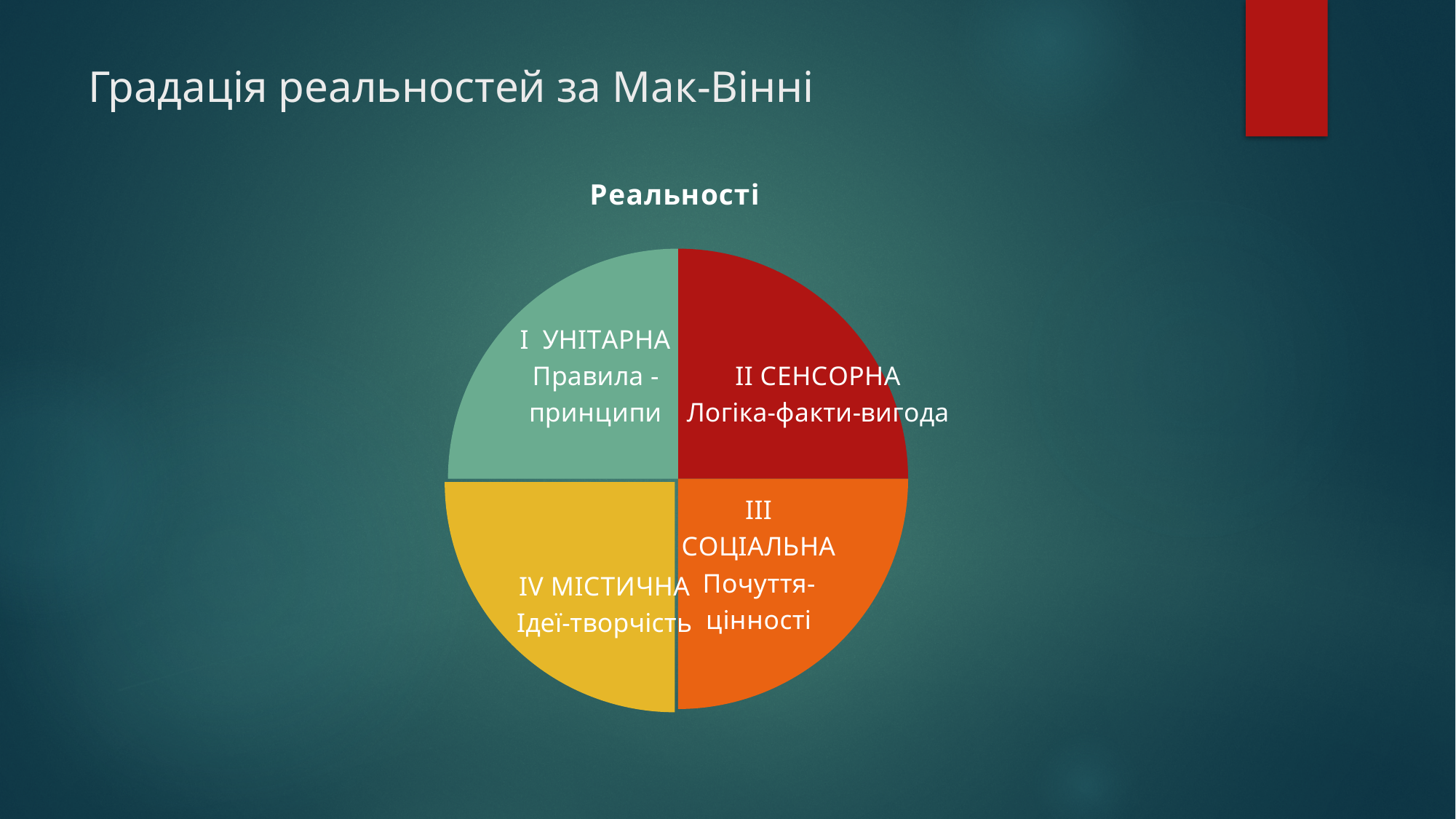
How many slices does the pie chart have? 4 What is the title of the pie chart? Реальності What description is written on the "III СОЦІАЛЬНА" slice of the pie chart? Почуття-цінності Which slice of the pie chart carries the description "Логіка-факти-вигода"? II СЕНСОРНА What description is written on the "IV МІСТИЧНА" slice of the pie chart? Ідеї-творчість What kind of chart is shown on the slide? pie chart Which slice of the pie chart is coloured dark red? II СЕНСОРНА What description is written on the "I УНІТАРНА" slice of the pie chart? Правила - принципи